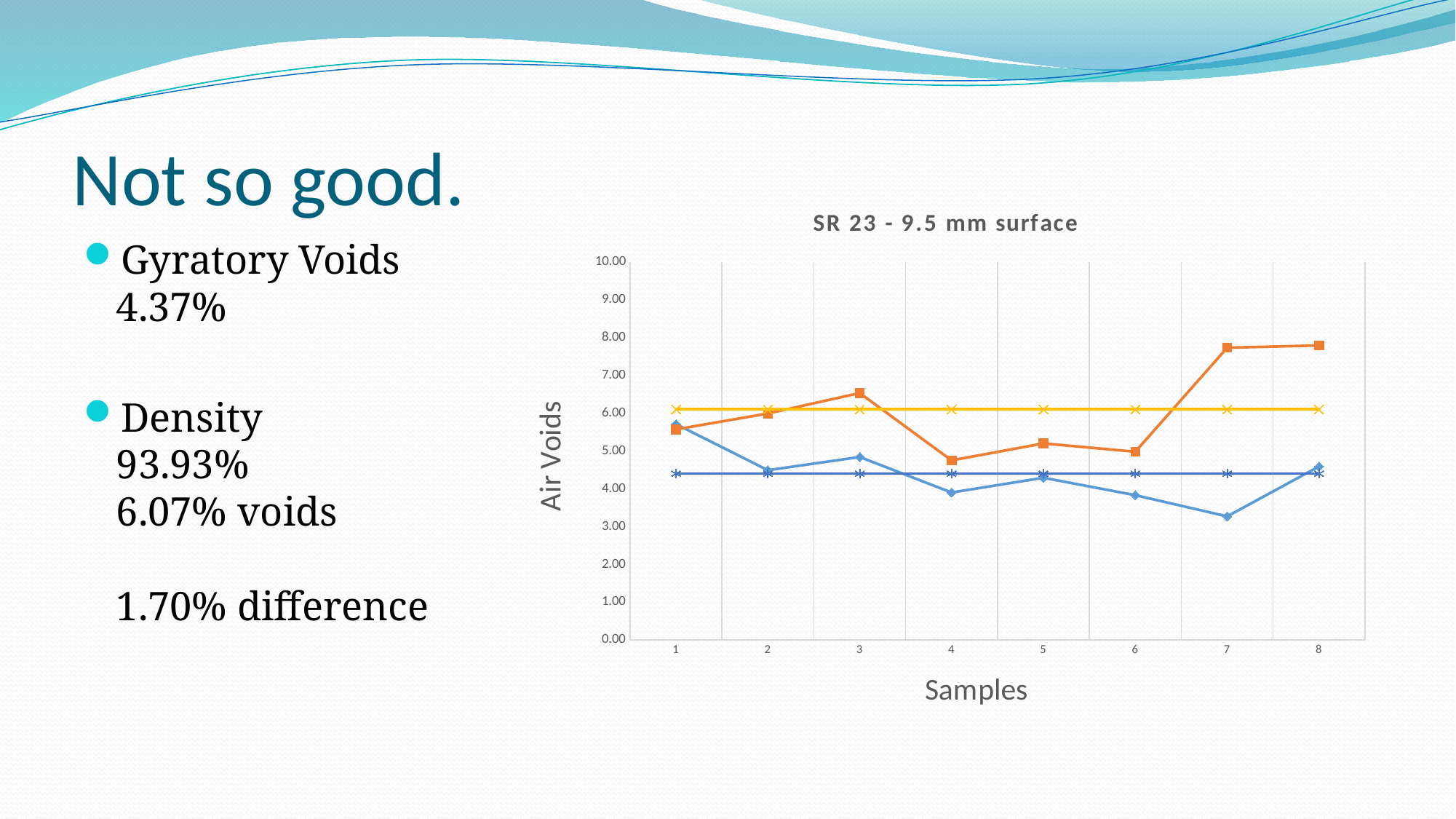
Is the value of the light blue line at sample 7 greater or less than 4.00? less At which sample does the light blue line reach its highest value? 1 At which sample does the light blue line reach its lowest value? 7 Is the value of the orange line at sample 7 greater or less than 7.00? greater What kind of chart is shown on the slide? line chart What is the title of the chart? SR 23 - 9.5 mm surface What is the label of the y axis of the chart? Air Voids Does the orange line rise or fall between sample 6 and sample 7? rise At sample 7, which line has the larger value, the orange line or the light blue line? orange line Is the value of the light blue line at sample 1 greater or less than 5.00? greater How many samples are plotted along the x axis of the chart? 8